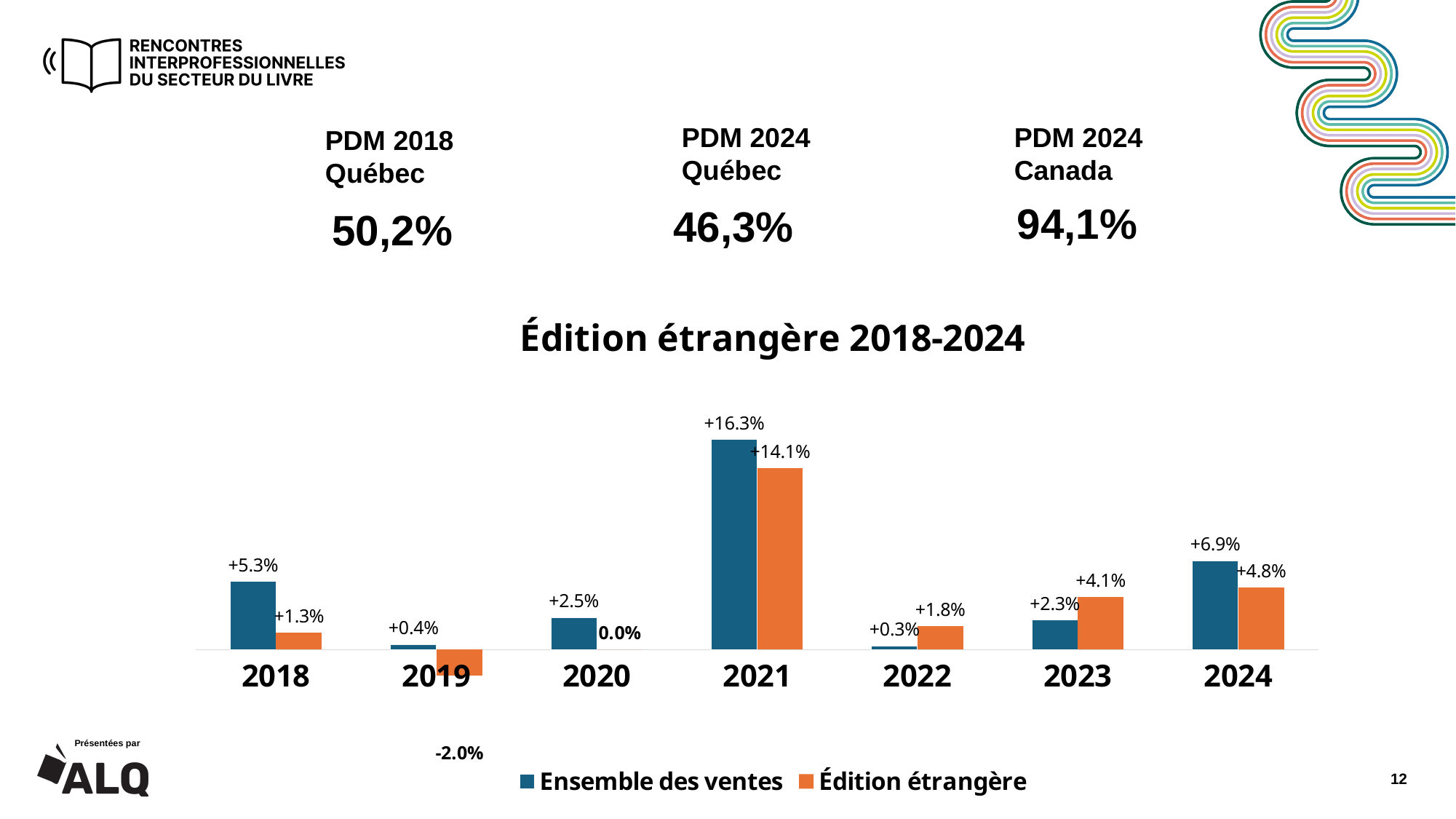
What is the title of the chart on the slide? Édition étrangère 2018-2024 Which colour represents Édition étrangère in the chart? orange In 2023, which series has the larger value, Ensemble des ventes or Édition étrangère? Édition étrangère What kind of chart is shown on the slide? bar chart What is the value for Édition étrangère in 2019? -2.0% How many series does the chart's legend list? 2 What is the value for Édition étrangère in 2023? +4.1% What is the difference between Ensemble des ventes and Édition étrangère in 2024? 2.1% How many years are shown on the x axis of the chart? 7 In which year is the Édition étrangère value lowest? 2019 What is the value for Ensemble des ventes in 2021? +16.3% In which year is the Ensemble des ventes value highest? 2021